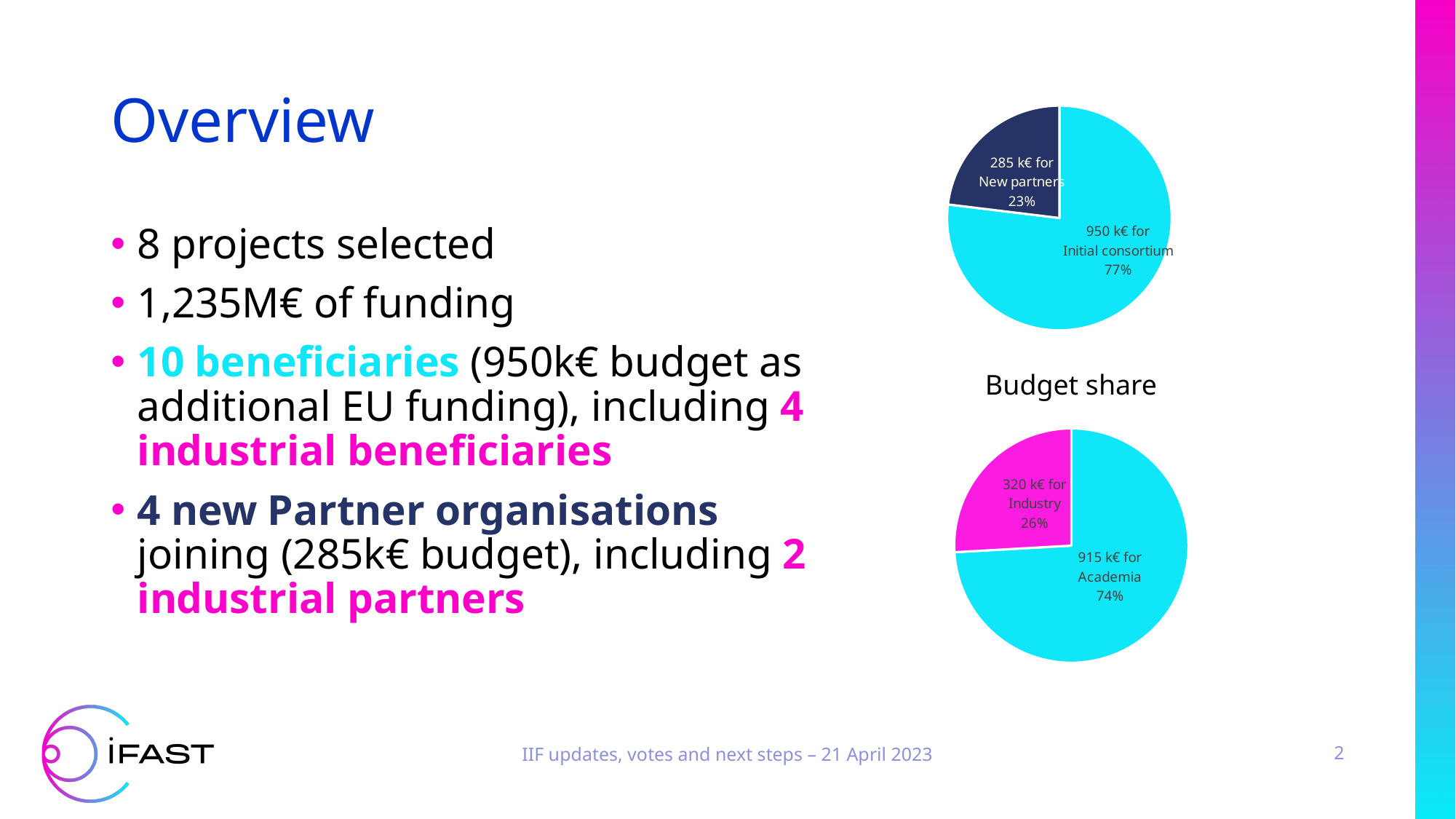
In the bottom pie chart, what amount is shown for Industry? 320 k€ In the bottom pie chart, which slice is the smallest? Industry In the bottom pie chart, what colour is the Industry slice? magenta In the bottom pie chart, what is the total of the Industry and Academia amounts? 1235 k€ What type of chart is the top chart on the right of the slide? pie chart In the bottom pie chart, what share of the pie does Academia hold? 74% In the top pie chart, what share of the pie does the Initial consortium hold? 77% In the top pie chart, what is the difference in k€ between the Initial consortium and New partners amounts? 665 k€ In the top pie chart, what share of the pie do New partners hold? 23% In the top pie chart, which slice is the largest? Initial consortium In the top pie chart, what amount is shown for New partners? 285 k€ How many slices does the top pie chart have? 2